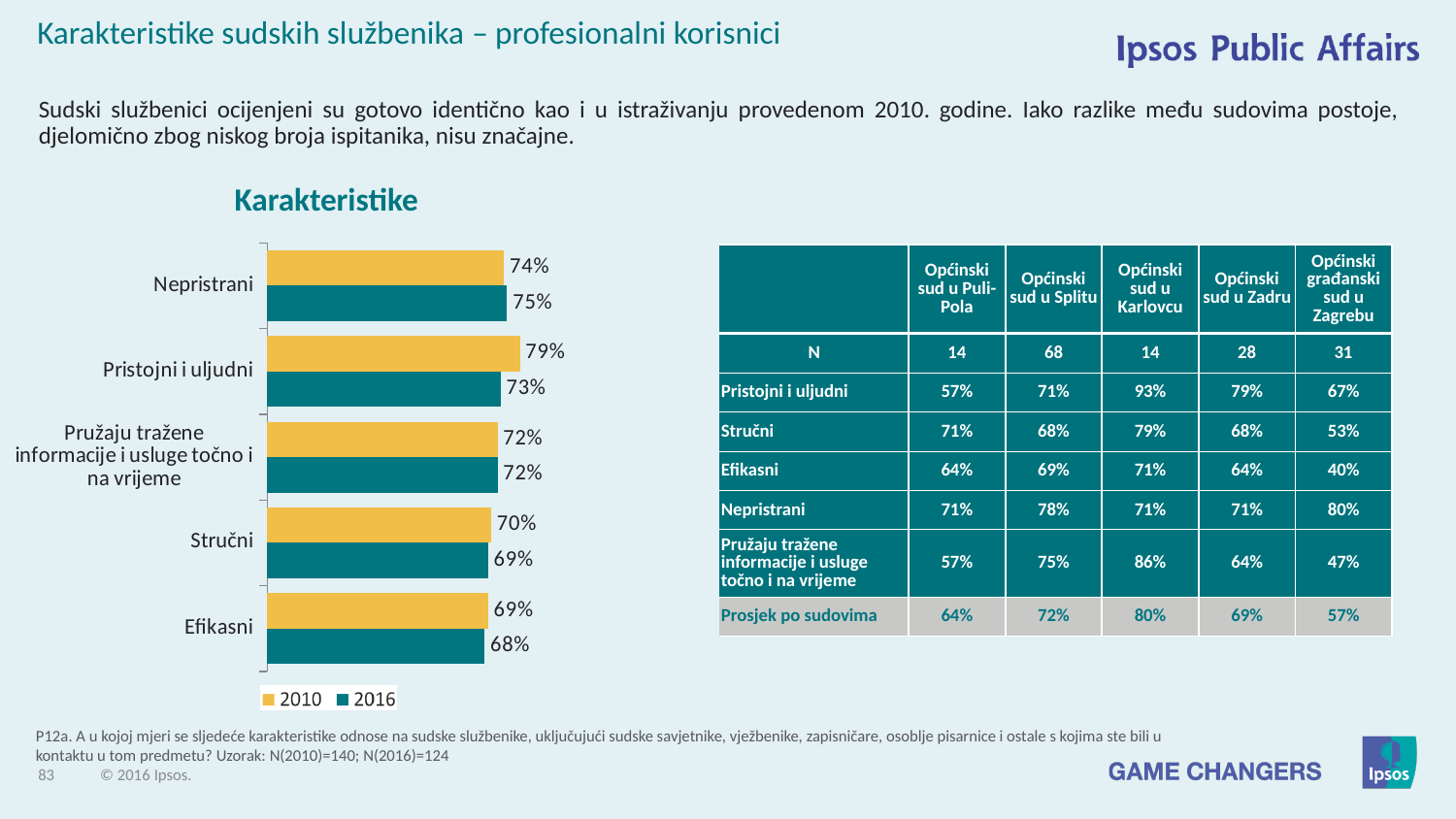
Which category has the highest 2010 value? Pristojni i uljudni How many series does the chart legend list? 2 What is the 2016 value for Efikasni? 68% Which series is shown in yellow in the chart? 2010 Which category has the lowest 2016 value? Efikasni What is the difference between the 2010 and 2016 values for Pristojni i uljudni? 6% What is the 2016 value for Pristojni i uljudni? 73% Which is larger for Nepristrani, the 2010 value or the 2016 value? 2016 What is the 2010 value for Stručni? 70% What type of chart is shown on the slide? bar chart What is the 2010 value for Nepristrani? 74% How many categories are shown in the chart? 5